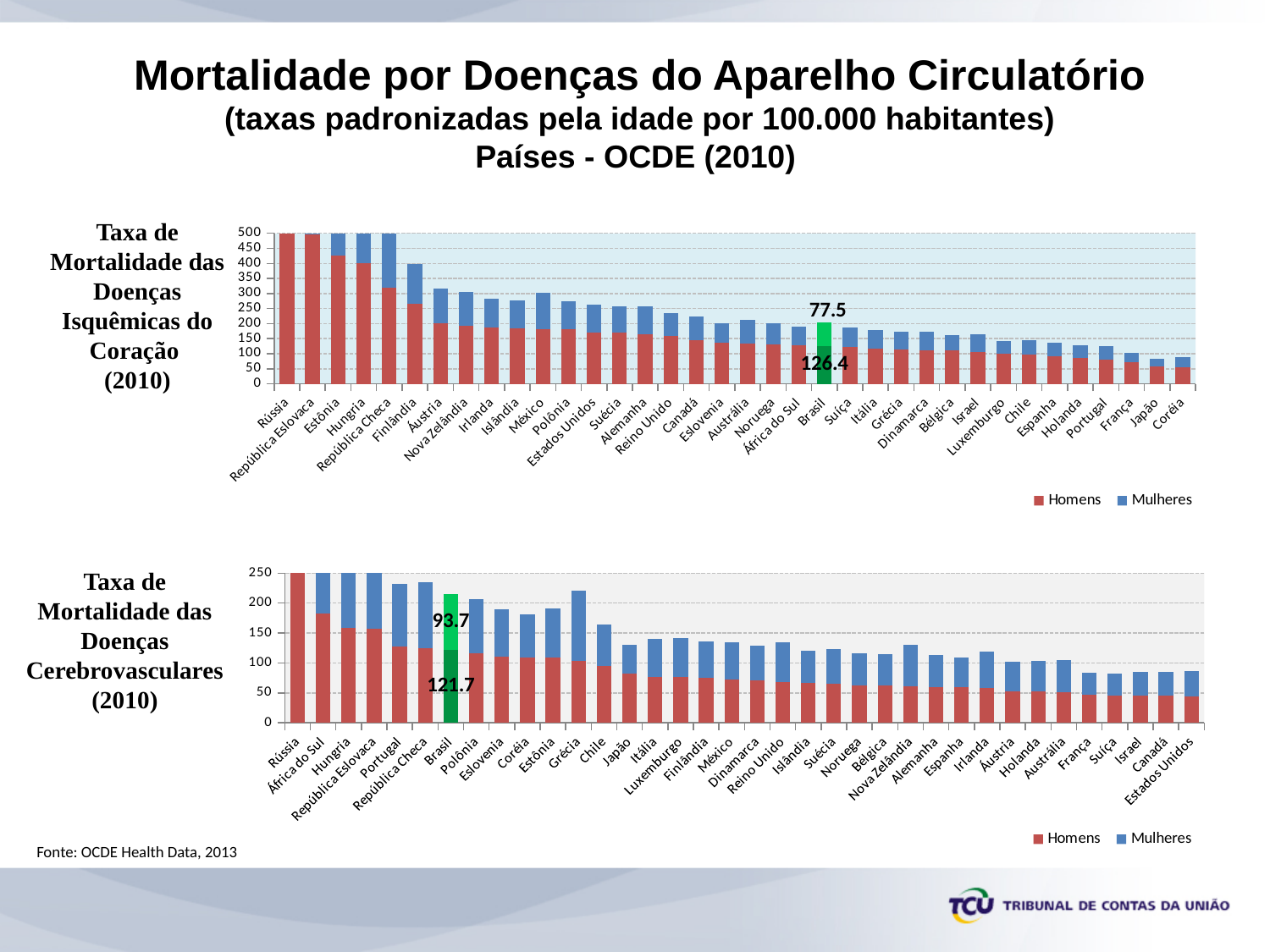
In the top chart (Doenças Isquêmicas do Coração), what is the difference between the Homens and Mulheres values for Brasil? 48.9 In the top chart (Doenças Isquêmicas do Coração), what is the total height of the stacked bar for Brasil? 203.9 In the top chart (Doenças Isquêmicas do Coração), is the total value for Finlândia greater or less than 350? greater In the bottom chart (Doenças Cerebrovasculares), what is the Homens value for Brasil? 121.7 In the bottom chart (Doenças Cerebrovasculares), is the total value for Chile greater or less than 200? less In the bottom chart (Doenças Cerebrovasculares), what is the Mulheres value for Brasil? 93.7 In the top chart (Doenças Isquêmicas do Coração), what is the Homens value for Brasil? 126.4 In the bottom chart (Doenças Cerebrovasculares), which has the taller stacked bar, Portugal or Chile? Portugal How many series does the legend of the top chart list? 2 In the top chart (Doenças Isquêmicas do Coração), what is the Mulheres value for Brasil? 77.5 In the bottom chart (Doenças Cerebrovasculares), do the stacked bar totals generally rise or fall from left to right? fall In the bottom chart (Doenças Cerebrovasculares), what is the total of the stacked bar for Brasil? 215.4